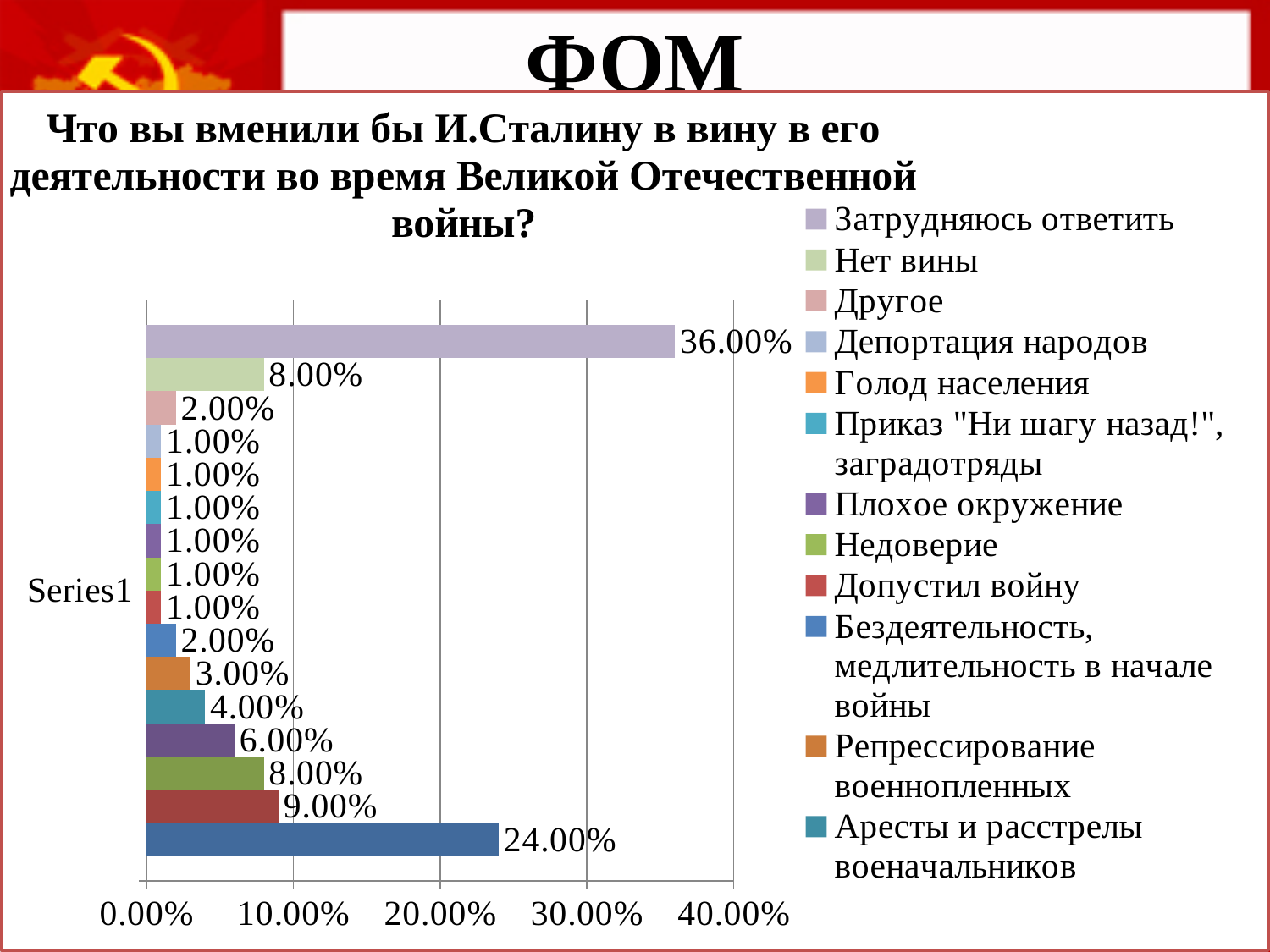
What kind of chart is shown on the slide? bar chart What is the value shown for Другое (the pink bar)? 2.00% Is the value of the bottom bar greater or less than 20.00%? greater Which is larger: the value for Затрудняюсь ответить or the value for Нет вины? Затрудняюсь ответить What is the value of the longest bar in the chart? 36.00% How many entries does the legend list? 12 What is the value shown for Нет вины (the light green bar)? 8.00% What is the difference between the top bar (36.00%) and the bottom bar (24.00%)? 12.00% What is the value shown for Депортация народов (the light blue bar)? 1.00% How many bars are plotted in the chart? 16 What is the value of the bottom bar in the chart? 24.00% What is the value shown for Затрудняюсь ответить (the lavender bar)? 36.00%